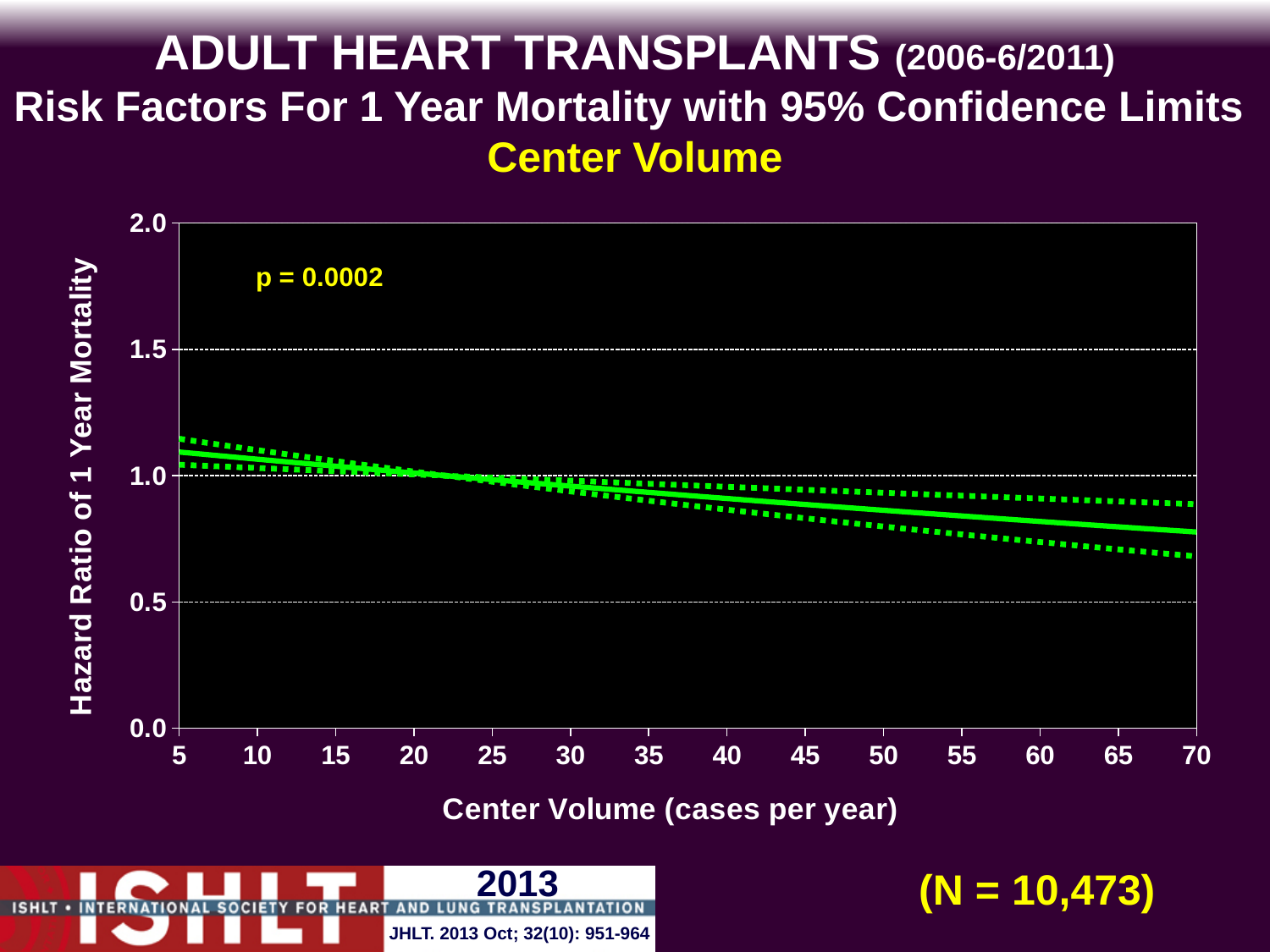
What is the p-value shown on the chart? p = 0.0002 Does the hazard ratio of 1 year mortality rise or fall as center volume increases along the x axis? fall What is the label of the x axis? Center Volume (cases per year) What kind of chart is shown on the slide? line chart Is the upper 95% confidence limit at a center volume of 70 greater or less than 1.0? less Is the hazard ratio at a center volume of 5 larger or smaller than the hazard ratio at a center volume of 70? larger Is the lower 95% confidence limit at a center volume of 70 greater or less than 0.5? greater How many lines are plotted on the chart (including the confidence limits)? 3 What is the highest value shown on the y axis? 2.0 Is the hazard ratio (solid line) at a center volume of 5 cases per year greater or less than 1.0? greater